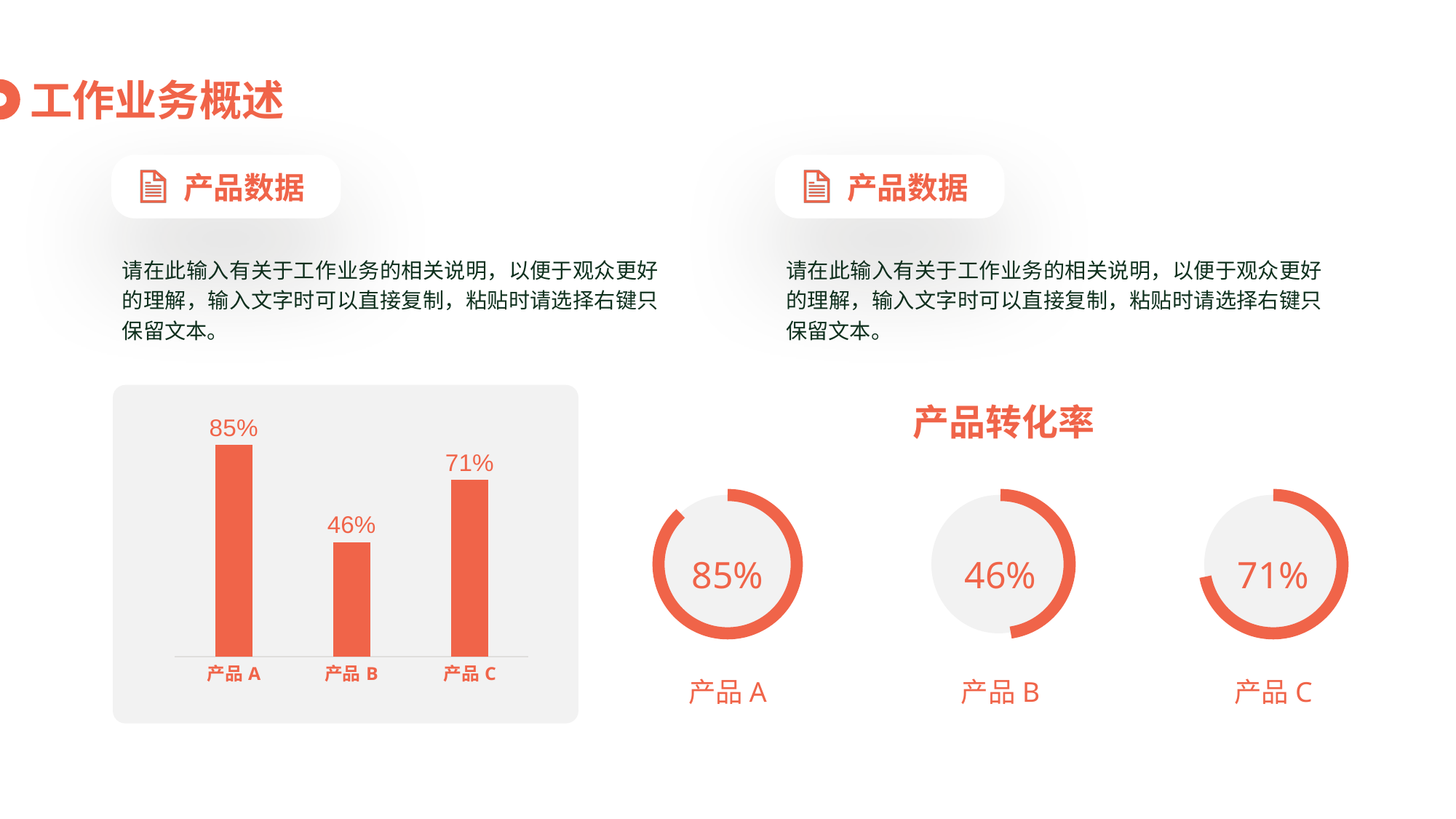
In the bar chart on the left, what is the value for 产品 B? 46% In the bar chart on the left, which product has the highest value? 产品 A In the 产品转化率 ring charts on the right, what is the value shown for 产品 B? 46% What is the title of the ring charts on the right of the slide? 产品转化率 In the bar chart on the left, what is the value for 产品 A? 85% In the bar chart on the left, what is the value for 产品 C? 71% How many bars are in the bar chart on the left? 3 In the bar chart on the left, what is the difference between the values for 产品 C and 产品 B? 25% In the bar chart on the left, which is larger, the value for 产品 C or the value for 产品 B? 产品 C In the bar chart on the left, which product has the lowest value? 产品 B In the bar chart on the left, what is the difference between the values for 产品 A and 产品 B? 39% What kind of chart is shown on the left of the slide? Bar chart